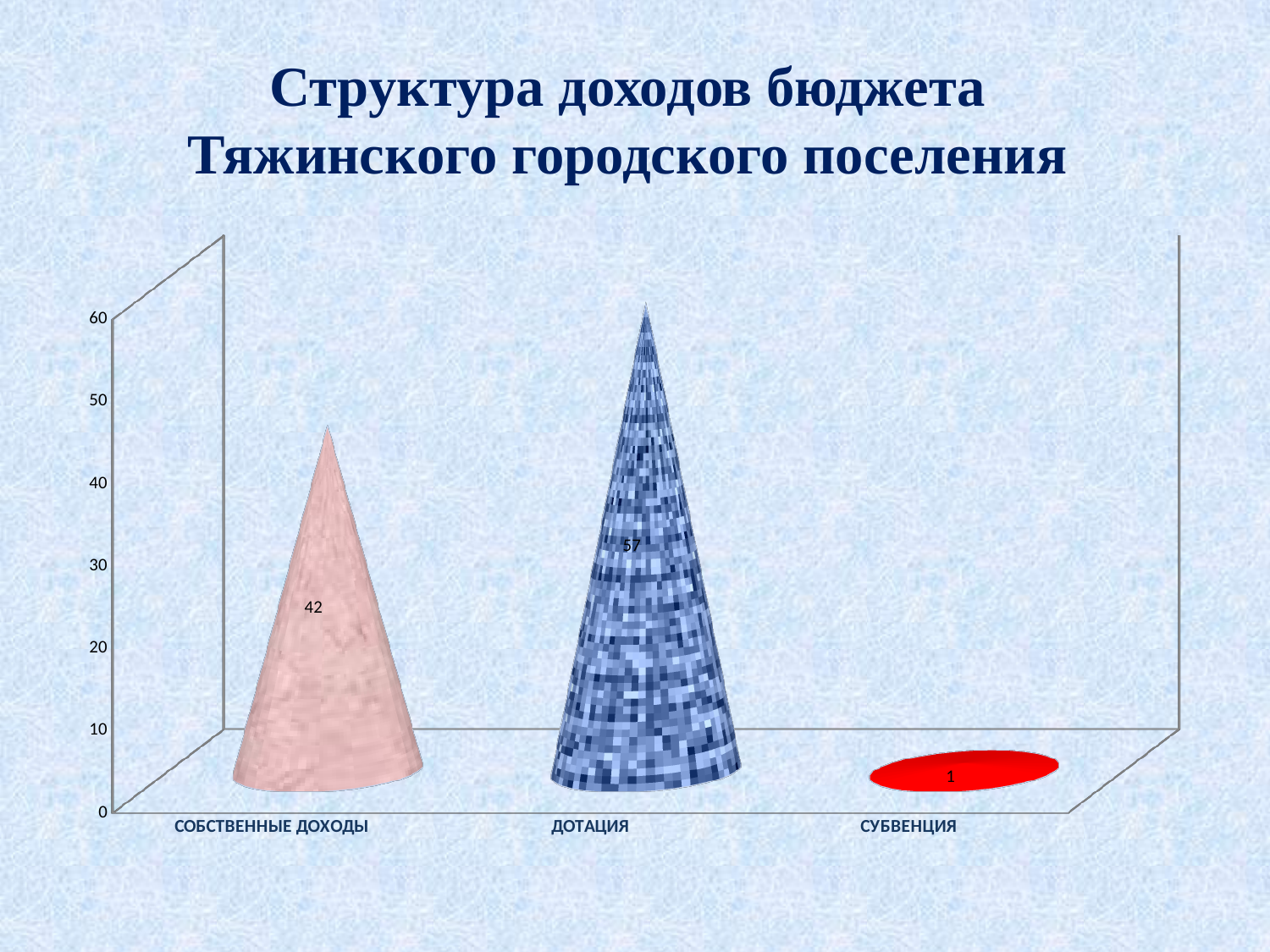
What is the value for СУБВЕНЦИЯ? 1 How many categories are shown on the chart? 3 What is the difference between the values for ДОТАЦИЯ and СОБСТВЕННЫЕ ДОХОДЫ? 15 What is the value for СОБСТВЕННЫЕ ДОХОДЫ? 42 What is the title of the slide? Структура доходов бюджета Тяжинского городского поселения Which category has the highest value? ДОТАЦИЯ What kind of chart is shown on the slide? bar chart Which category has the lowest value? СУБВЕНЦИЯ What is the difference between the values for СОБСТВЕННЫЕ ДОХОДЫ and СУБВЕНЦИЯ? 41 Which is larger, the value for СОБСТВЕННЫЕ ДОХОДЫ or the value for ДОТАЦИЯ? ДОТАЦИЯ Is the value for ДОТАЦИЯ greater or less than 50? greater What is the value for ДОТАЦИЯ? 57